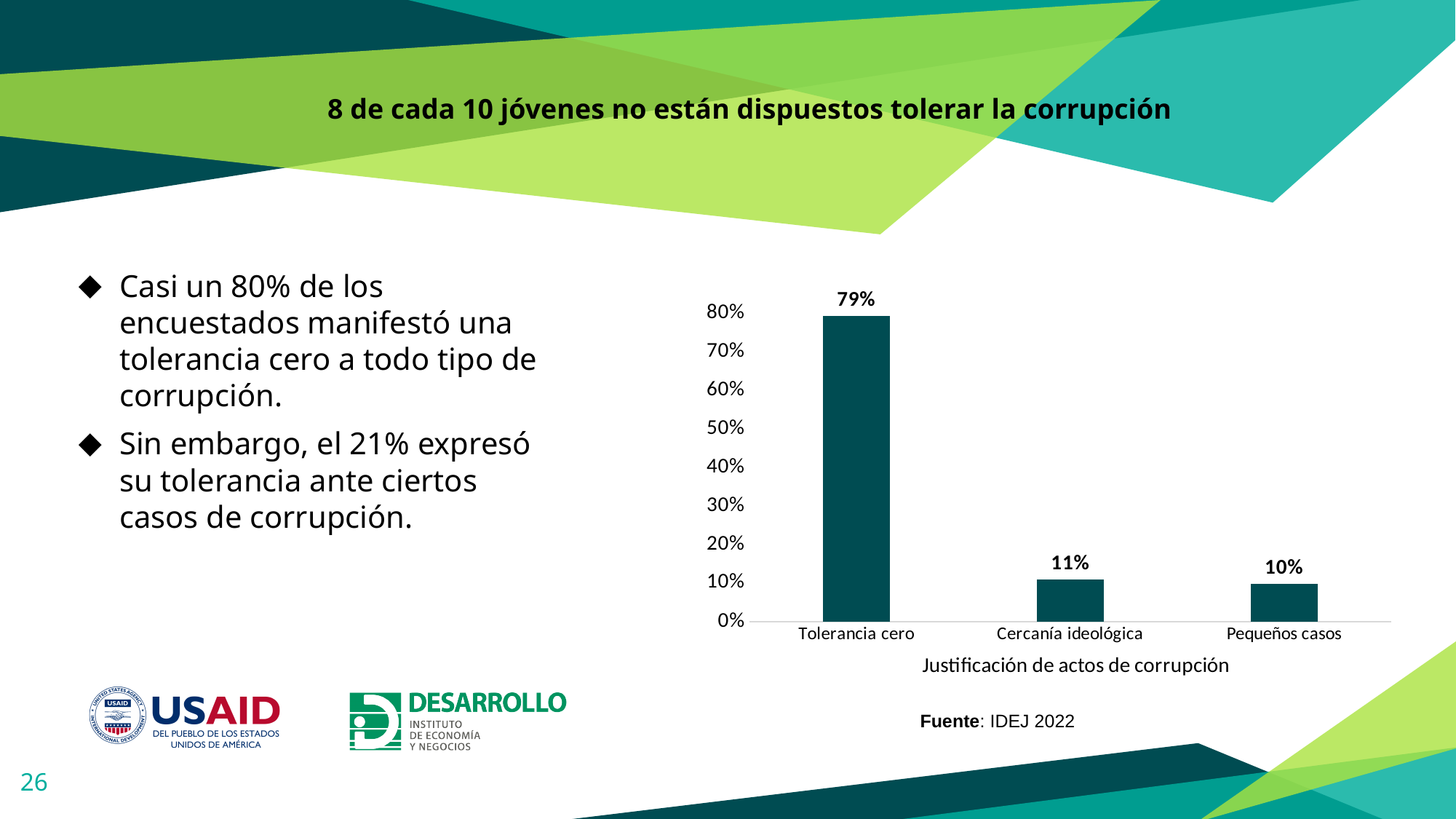
What is the difference between the values for Tolerancia cero and Cercanía ideológica? 68% How many categories are shown on the x axis? 3 What kind of chart is shown on the slide? bar chart Which category has the lowest value? Pequeños casos What is the value for Tolerancia cero? 79% Which is larger, the value for Tolerancia cero or the value for Pequeños casos? Tolerancia cero What is the difference between the values for Cercanía ideológica and Pequeños casos? 1% Which category has the highest value? Tolerancia cero What is the value for Pequeños casos? 10% What is the x-axis title of the chart? Justificación de actos de corrupción Is the value for Tolerancia cero greater or less than 70%? greater What is the value for Cercanía ideológica? 11%